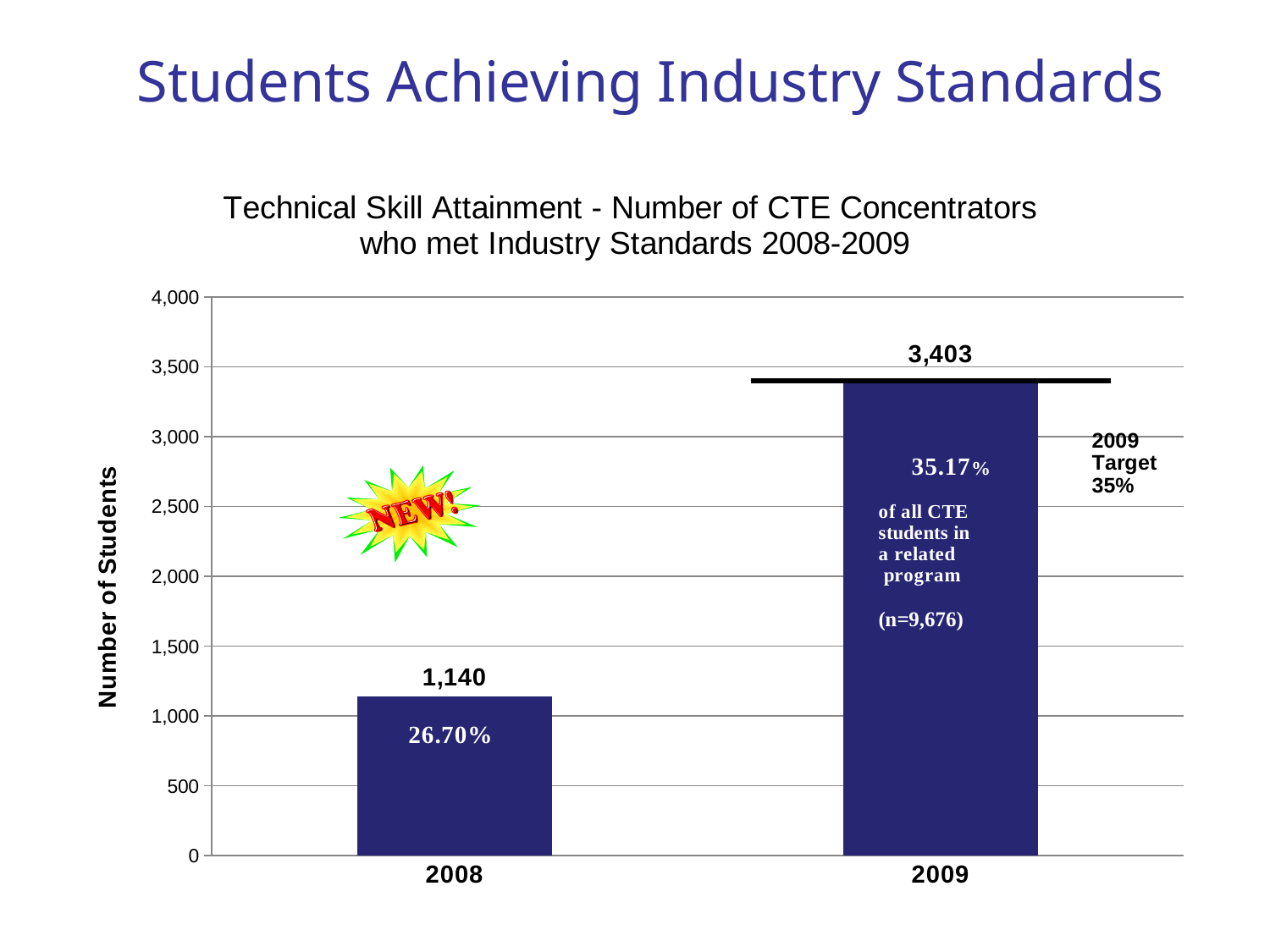
Is the value for 2009 greater or less than 3,500? less What is the difference in number of students between 2009 and 2008? 2,263 Is the value for 2008 greater or less than 1,000? greater What is the 2009 target percentage shown on the chart? 35% What is the number of students for 2009? 3,403 Which year has the lower number of students? 2008 What kind of chart is this? bar chart How many years are shown on the x axis? 2 Which year has the higher number of students? 2009 What is the number of students for 2008? 1,140 What percentage is printed on the 2008 bar? 26.70% Do the values rise or fall from 2008 to 2009? rise